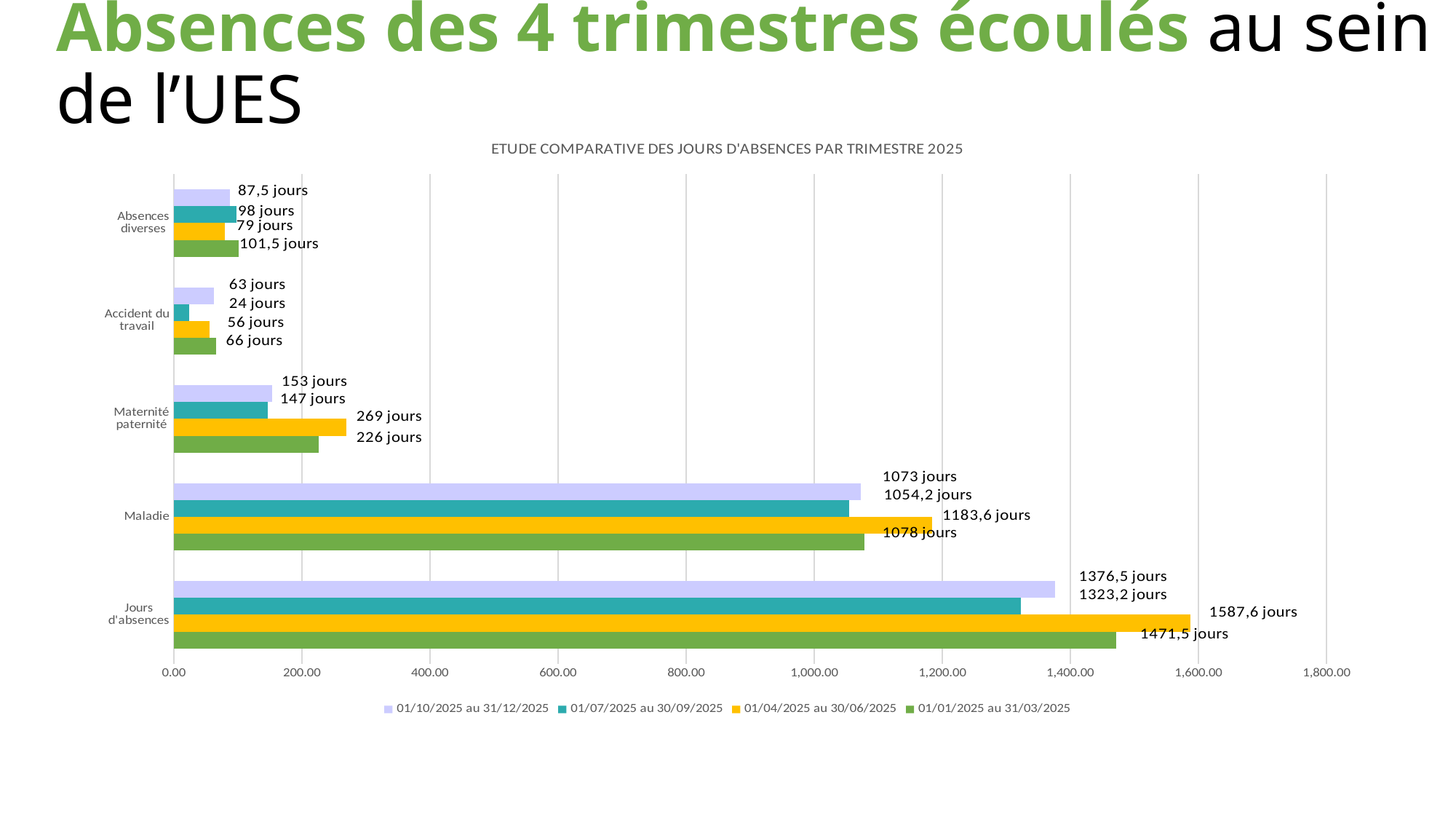
What is the difference between the 01/04/2025 au 30/06/2025 and 01/01/2025 au 31/03/2025 values for Maternité paternité? 43 jours Which series has the lowest value for Maternité paternité? 01/07/2025 au 30/09/2025 How many series does the legend list? 4 What is the value for Jours d'absences in the series 01/01/2025 au 31/03/2025? 1471,5 jours Which series has the highest value for Jours d'absences? 01/04/2025 au 30/06/2025 How many categories are shown on the vertical axis? 5 What is the value for Accident du travail in the series 01/07/2025 au 30/09/2025? 24 jours For Absences diverses, which is larger: the value for 01/07/2025 au 30/09/2025 or the value for 01/04/2025 au 30/06/2025? 01/07/2025 au 30/09/2025 What is the title of the chart? ETUDE COMPARATIVE DES JOURS D'ABSENCES PAR TRIMESTRE 2025 Is the value for Maladie in the series 01/10/2025 au 31/12/2025 greater or less than 1,000.00? greater What is the value for Maladie in the series 01/04/2025 au 30/06/2025? 1183,6 jours What kind of chart is shown on the slide? Bar chart